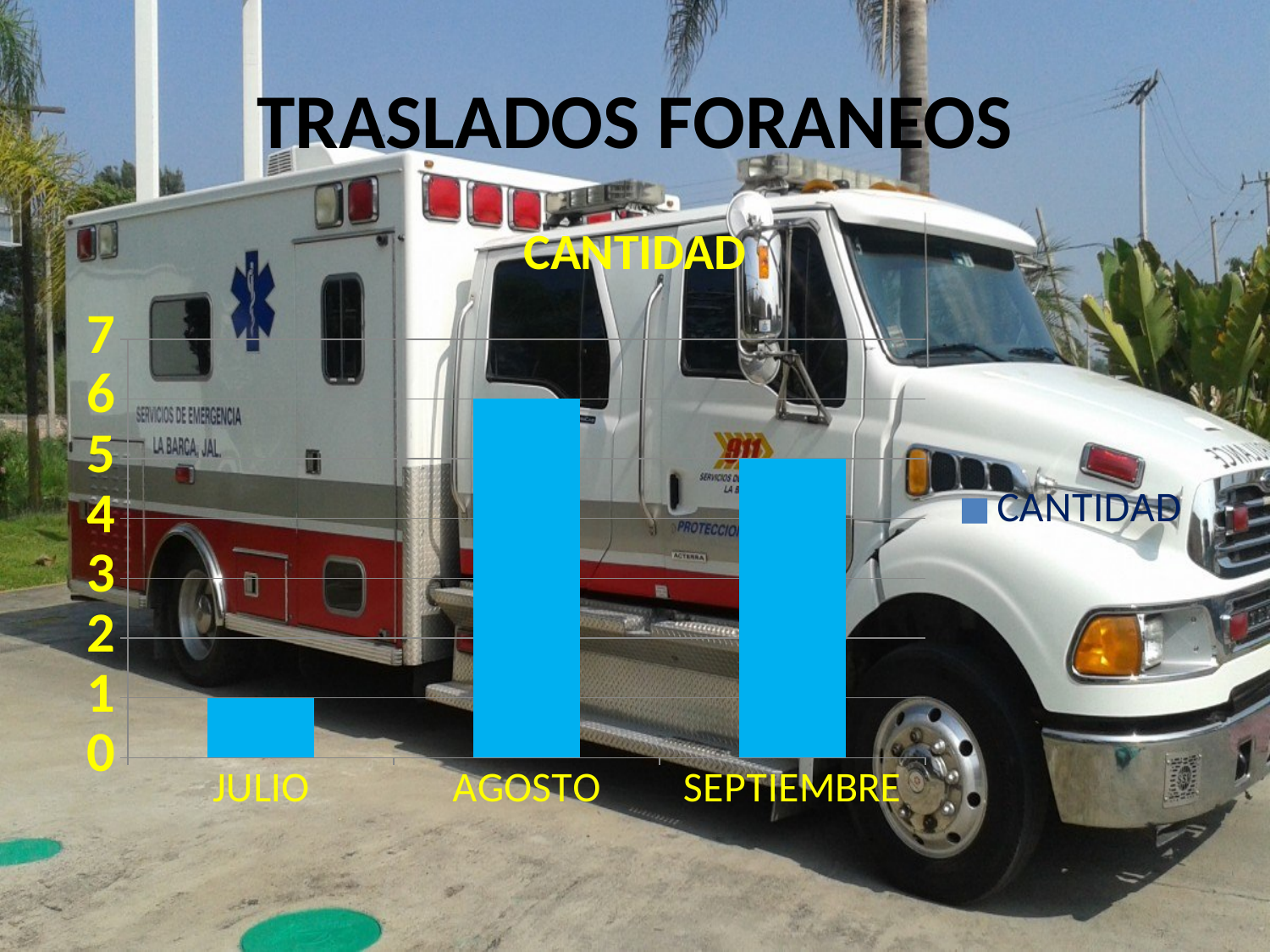
What kind of chart is shown on the slide? bar chart What is the value for SEPTIEMBRE? 5 Which is larger, the value for AGOSTO or the value for SEPTIEMBRE? AGOSTO What is the value for JULIO? 1 What is the difference between the values for AGOSTO and JULIO? 5 How many categories are shown on the x axis of the chart? 3 What is the value for AGOSTO? 6 Which month has the lowest value in the chart? JULIO What is the title of the chart? CANTIDAD How many series does the chart legend list? 1 Is the value for SEPTIEMBRE greater or less than 3? greater Which month has the highest value in the chart? AGOSTO